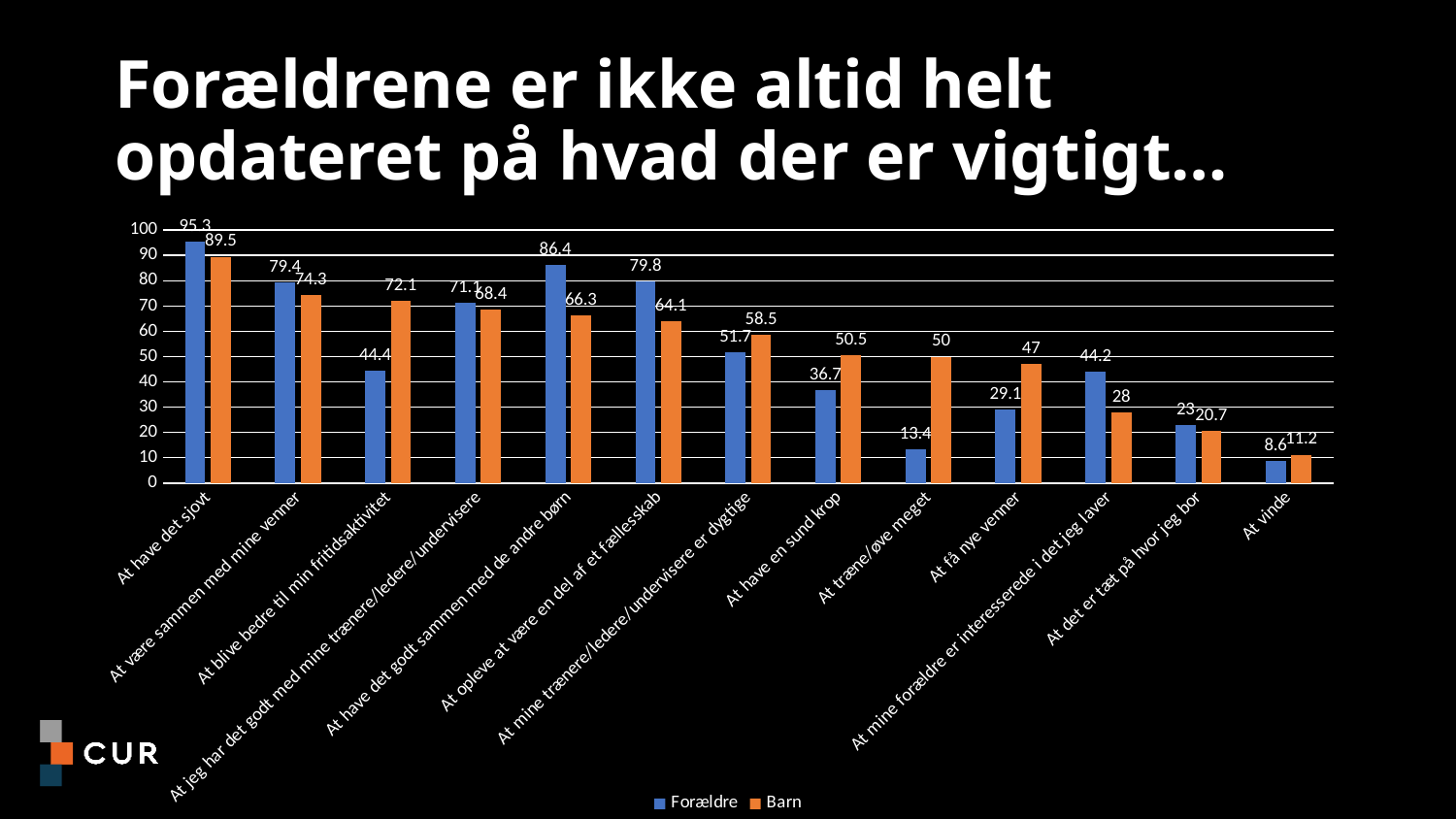
For "At have det godt sammen med de andre børn", which series has the larger value, Forældre or Barn? Forældre How many series does the legend list? 2 What is the Forældre value for "At mine forældre er interesserede i det jeg laver"? 44.2 Which category has the lowest Forældre value? At vinde For "At få nye venner", which series has the larger value, Forældre or Barn? Barn Which category has the highest Barn value? At have det sjovt What kind of chart is shown on the slide? Bar chart What is the difference between the Barn and Forældre values for "At træne/øve meget"? 36.6 What is the Forældre value for "At have det sjovt"? 95.3 What is the Barn value for "At blive bedre til min fritidsaktivitet"? 72.1 What is the Barn value for "At træne/øve meget"? 50 How many categories are shown on the x axis? 13